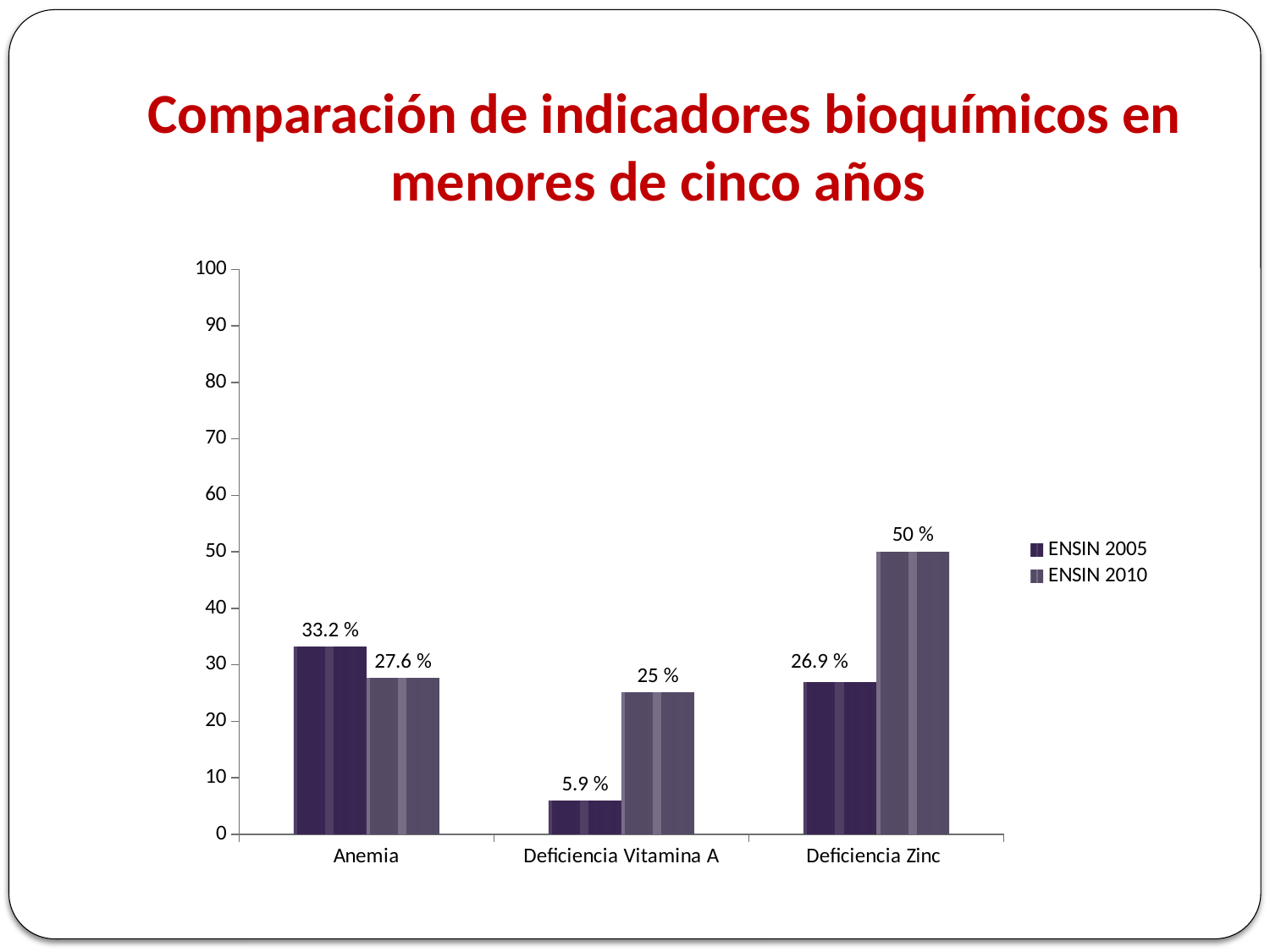
What is the difference between the ENSIN 2010 and ENSIN 2005 values for Deficiencia Zinc? 23.1 % What is the ENSIN 2005 value for Anemia? 33.2 % What is the title of the slide? Comparación de indicadores bioquímicos en menores de cinco años Which category has the lowest ENSIN 2005 value? Deficiencia Vitamina A What is the ENSIN 2005 value for Deficiencia Vitamina A? 5.9 % Which is larger for Anemia, the ENSIN 2005 value or the ENSIN 2010 value? ENSIN 2005 How many categories are shown on the x axis? 3 What is the ENSIN 2010 value for Anemia? 27.6 % What kind of chart is shown on the slide? Bar chart What is the ENSIN 2010 value for Deficiencia Zinc? 50 % How many series does the legend list? 2 Which category has the highest ENSIN 2010 value? Deficiencia Zinc